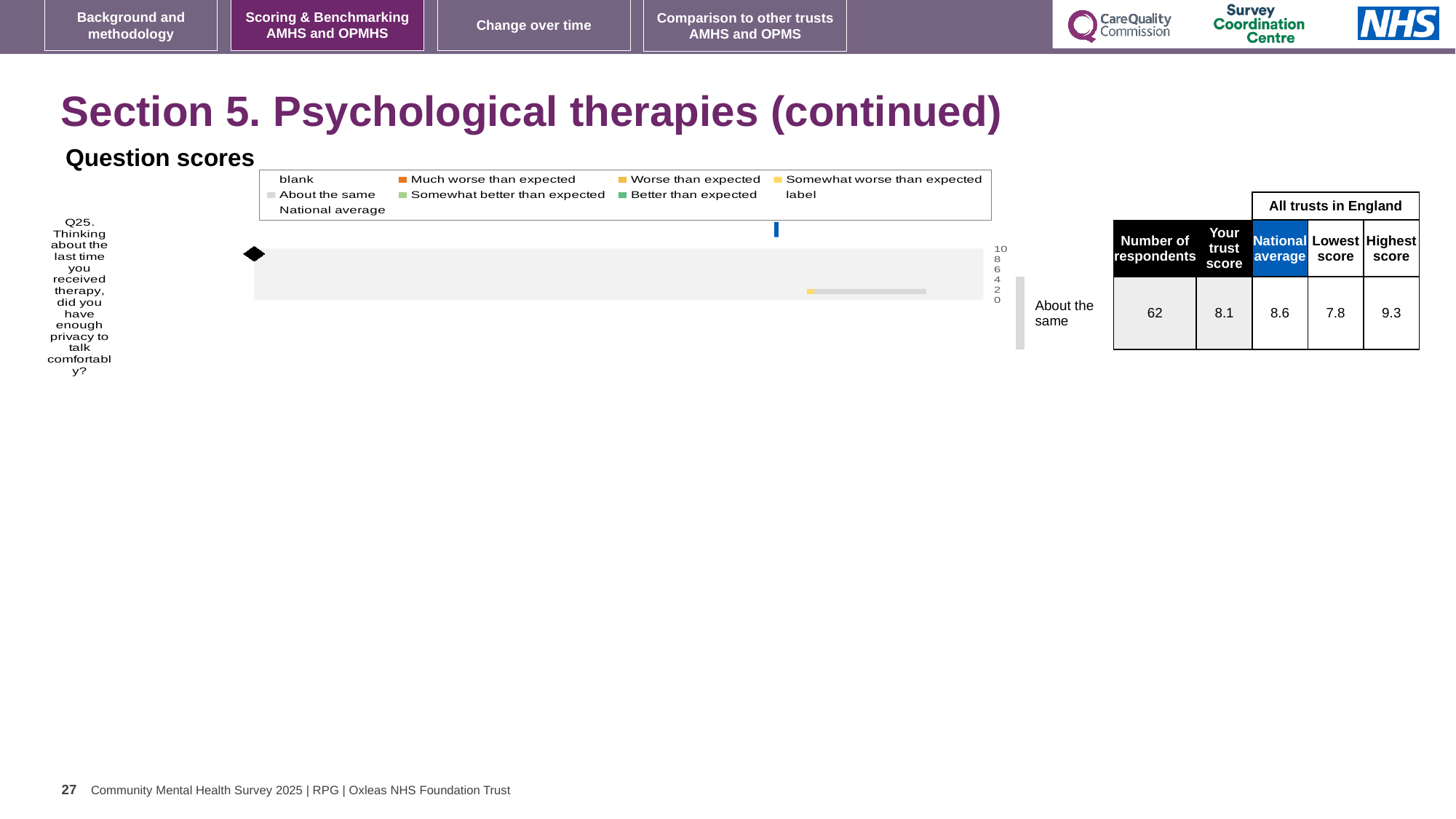
According to the table beside the chart, what is the lowest score among all trusts in England for Q25? 7.8 According to the table beside the chart, what is the national average for Q25? 8.6 What is the highest tick value shown on the axis of the Question scores chart? 10 According to the table beside the chart, what is the highest score among all trusts in England for Q25? 9.3 Which question is plotted in the Question scores chart? Q25. Thinking about the last time you received therapy, did you have enough privacy to talk comfortably? For Q25, is the trust score or the national average larger? national average What kind of chart is shown under 'Question scores'? bar chart How many questions (categories) are plotted in the Question scores chart? 1 How many entries does the legend of the Question scores chart list? 9 According to the table beside the chart, how many respondents answered Q25? 62 What benchmark category is shown next to the Q25 bar in the Question scores chart? About the same According to the table beside the chart, what is the trust score for Q25? 8.1